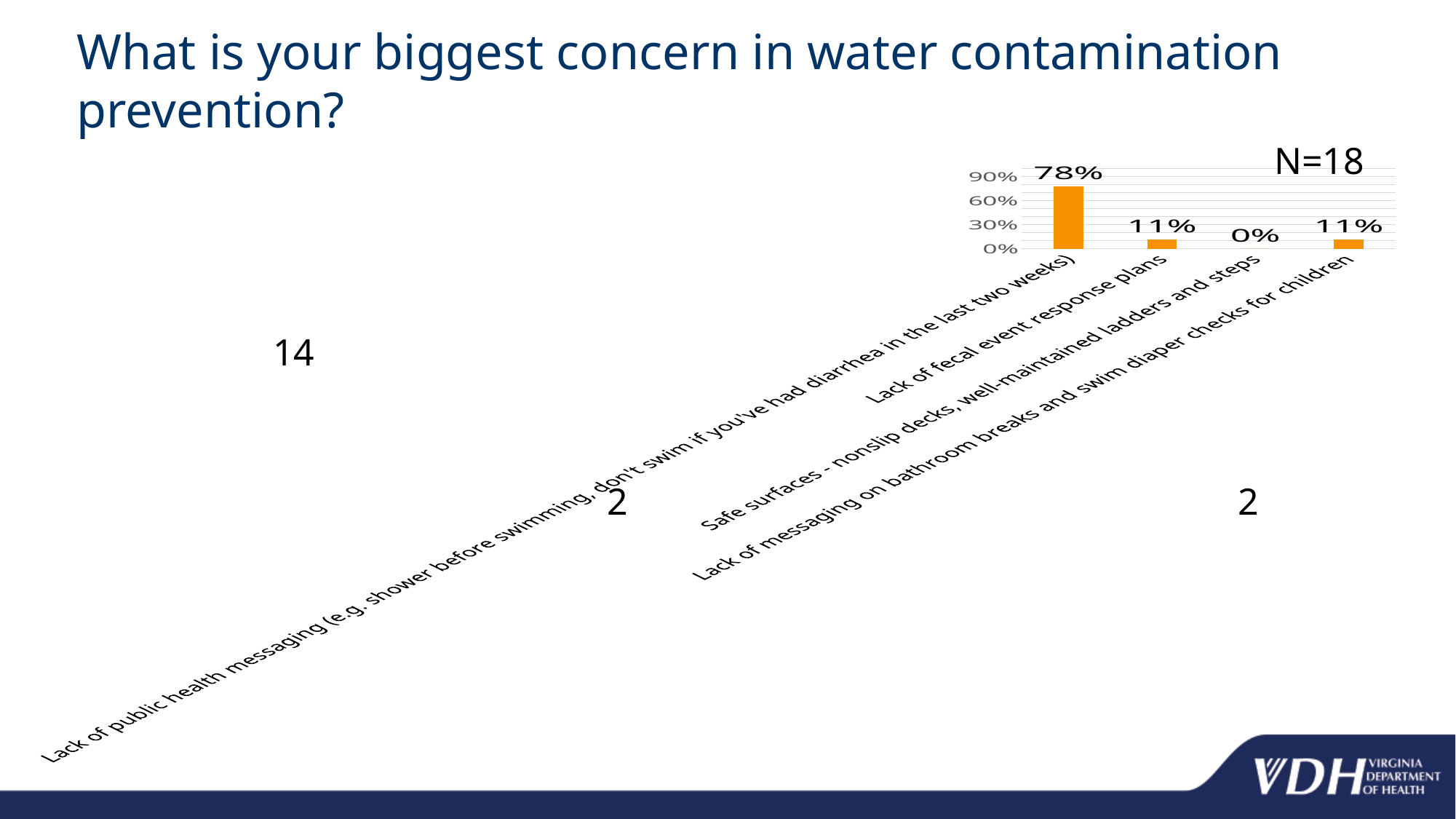
How many concern categories are shown in the chart? 4 What percentage is shown for "Lack of messaging on bathroom breaks and swim diaper checks for children"? 11% What is the sample size (N) noted on the chart? N=18 Which concern has the highest percentage in the chart? Lack of public health messaging What percentage is shown for "Lack of fecal event response plans"? 11% What is the difference in percentage points between "Lack of public health messaging" and "Lack of fecal event response plans"? 67 percentage points Is the value for "Lack of public health messaging" greater or less than 60%? greater Which concern has the lowest percentage in the chart? Safe surfaces - nonslip decks, well-maintained ladders and steps What type of chart is used on this slide? Bar chart What percentage of respondents chose "Lack of public health messaging" as their biggest concern in water contamination prevention? 78% What percentage is shown for "Safe surfaces - nonslip decks, well-maintained ladders and steps"? 0% Which is larger: the value for "Lack of public health messaging" or the value for "Lack of messaging on bathroom breaks and swim diaper checks for children"? Lack of public health messaging